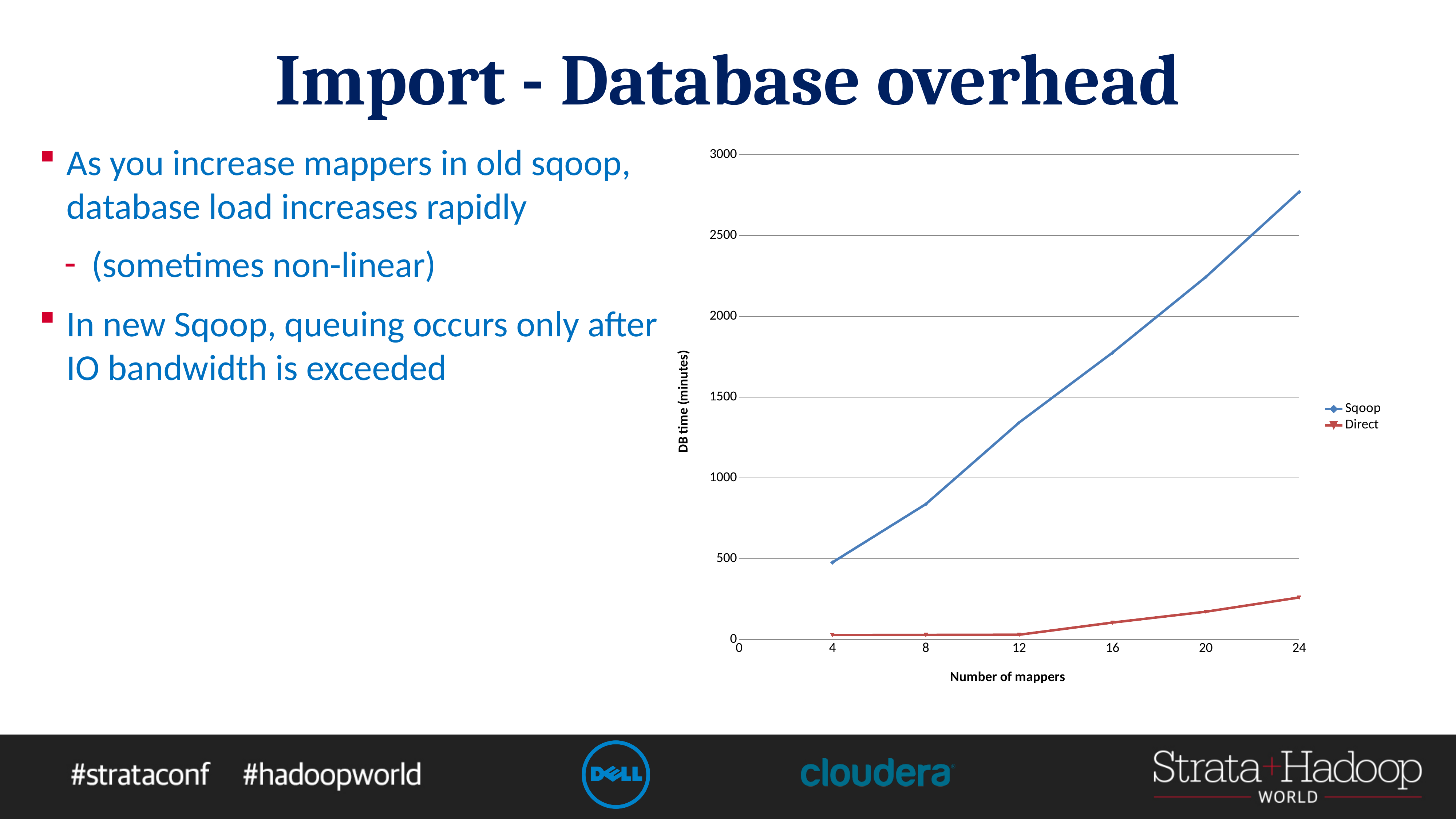
How many series does the chart's legend list? 2 At 24 mappers, which series has the larger DB time, Sqoop or Direct? Sqoop What kind of chart is shown on the slide? line chart Which colour is used for the Direct series in the chart? red Does the Sqoop series rise or fall as the number of mappers increases? rise Is the Sqoop value at 24 mappers greater or less than 2500? greater At which number of mappers does the Sqoop series reach its highest DB time? 24 Is the Direct value at 24 mappers greater or less than 500? less Is the Sqoop value at 16 mappers greater or less than 1500? greater How many data points are plotted for the Sqoop series? 6 What is the title of the chart's vertical axis? DB time (minutes)